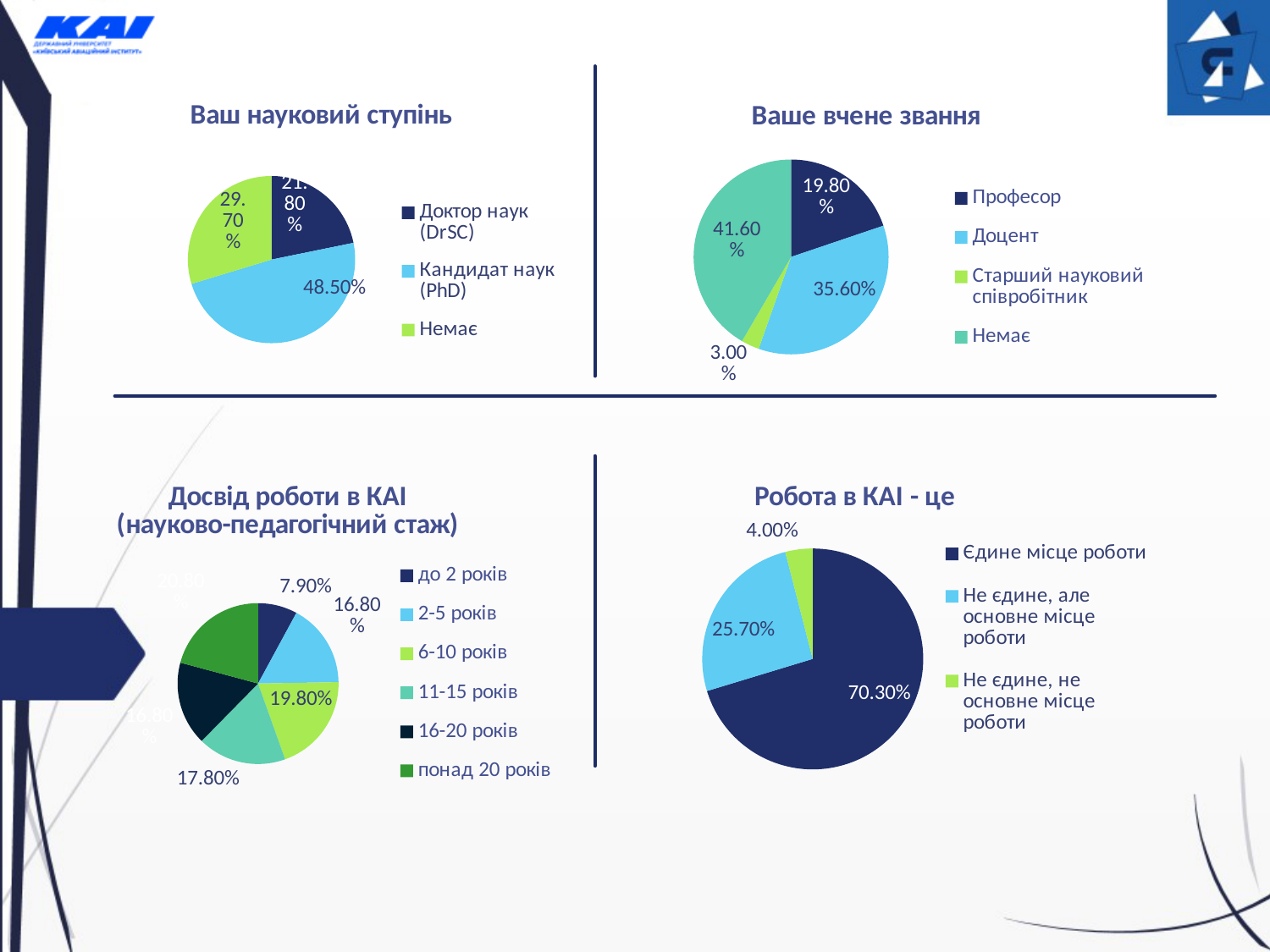
In the chart titled "Ваше вчене звання", what share is shown for "Старший науковий співробітник"? 3.00% In the chart titled "Ваш науковий ступінь", which category has the largest slice? Кандидат наук (PhD) In the chart titled "Досвід роботи в КАІ (науково-педагогічний стаж)", how many categories does the legend list? 6 In the chart titled "Ваш науковий ступінь", what share is shown for "Немає"? 29.70% What kind of chart is used for "Робота в КАІ - це"? Pie chart In the chart titled "Ваше вчене звання", how many categories does the legend list? 4 In the chart titled "Ваш науковий ступінь", what share is shown for "Кандидат наук (PhD)"? 48.50% In the chart titled "Робота в КАІ - це", what share is shown for "Єдине місце роботи"? 70.30% In the chart titled "Ваше вчене звання", which category has the smallest slice? Старший науковий співробітник In the chart titled "Ваше вчене звання", what share is shown for "Доцент"? 35.60% In the chart titled "Досвід роботи в КАІ (науково-педагогічний стаж)", what share is shown for "до 2 років"? 7.90% In the chart titled "Ваше вчене звання", what is the difference between the shares for "Немає" and "Професор"? 21.80%